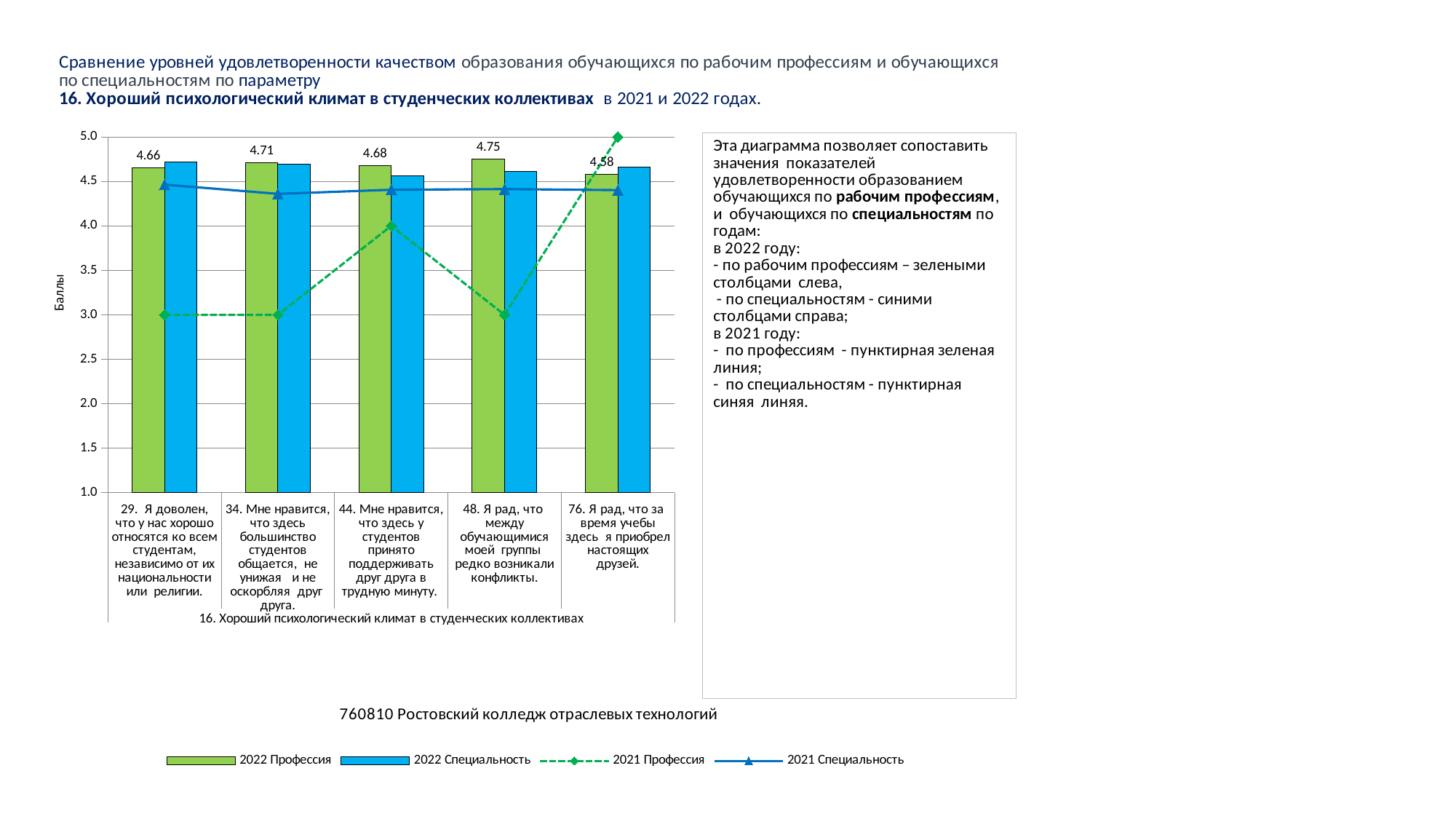
How many categories are shown on the x axis of the chart? 5 What is the value of the 2022 Профессия bar for the category "48. Я рад, что между обучающимися моей группы редко возникали конфликты."? 4.75 How many series does the legend list? 4 What is the value of the 2022 Профессия bar for the category "29. Я доволен, что у нас хорошо относятся ко всем студентам, независимо от их национальности или религии."? 4.66 Is the value of the 2021 Профессия line for category 29 greater or less than 3.5? less Which category has the highest 2022 Профессия value? 48. Я рад, что между обучающимися моей группы редко возникали конфликты. Which category has the larger 2022 Профессия value: category 34 or category 44? 34. Мне нравится, что здесь большинство студентов общается, не унижая и не оскорбляя друг друга. Which series is drawn as a dashed green line with diamond markers? 2021 Профессия What is the difference between the 2022 Профессия values for category 48 and category 76? 0.17 What kind of chart is shown on the slide? Combined bar and line chart What is the value of the 2021 Профессия line for the category "76. Я рад, что за время учебы здесь я приобрел настоящих друзей."? 5.0 Which category has the lowest 2022 Профессия value? 76. Я рад, что за время учебы здесь я приобрел настоящих друзей.